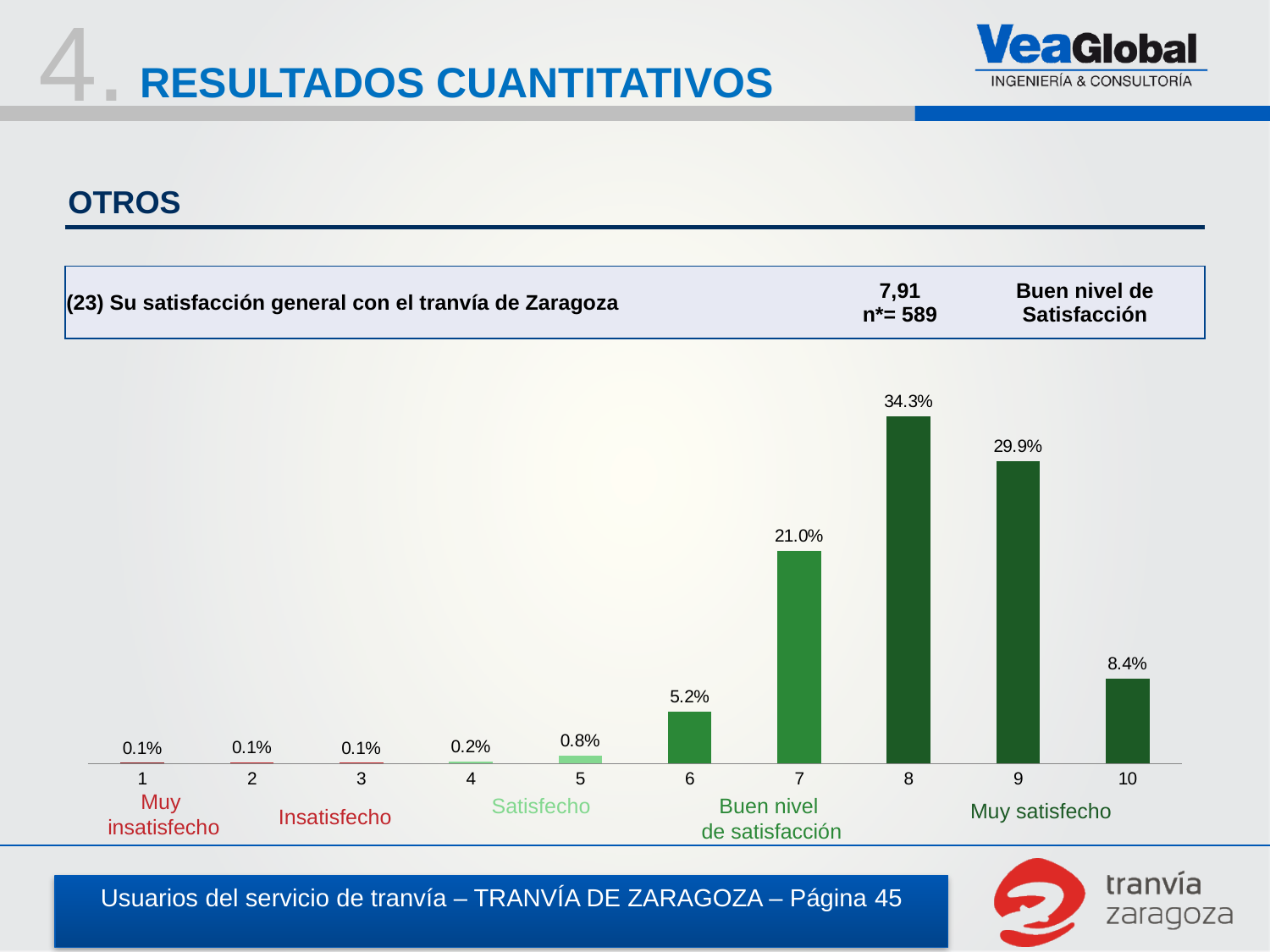
What is the difference in percentage points between score 8 and score 9? 4.4 How many score categories are shown on the x axis of the chart? 10 What kind of chart is used to show the satisfaction distribution? bar chart What percentage of respondents gave a satisfaction score of 5? 0.8% Which has a larger percentage of respondents, score 6 or score 7? 7 Which score category has the highest percentage of respondents? 8 What is the difference in percentage points between score 7 and score 6? 15.8 What percentage of respondents gave a satisfaction score of 10? 8.4% Which has a larger percentage of respondents, score 9 or score 10? 9 What percentage of respondents gave a satisfaction score of 8? 34.3% What is the average satisfaction score shown in the box above the chart? 7,91 What percentage of respondents gave a satisfaction score of 7? 21.0%